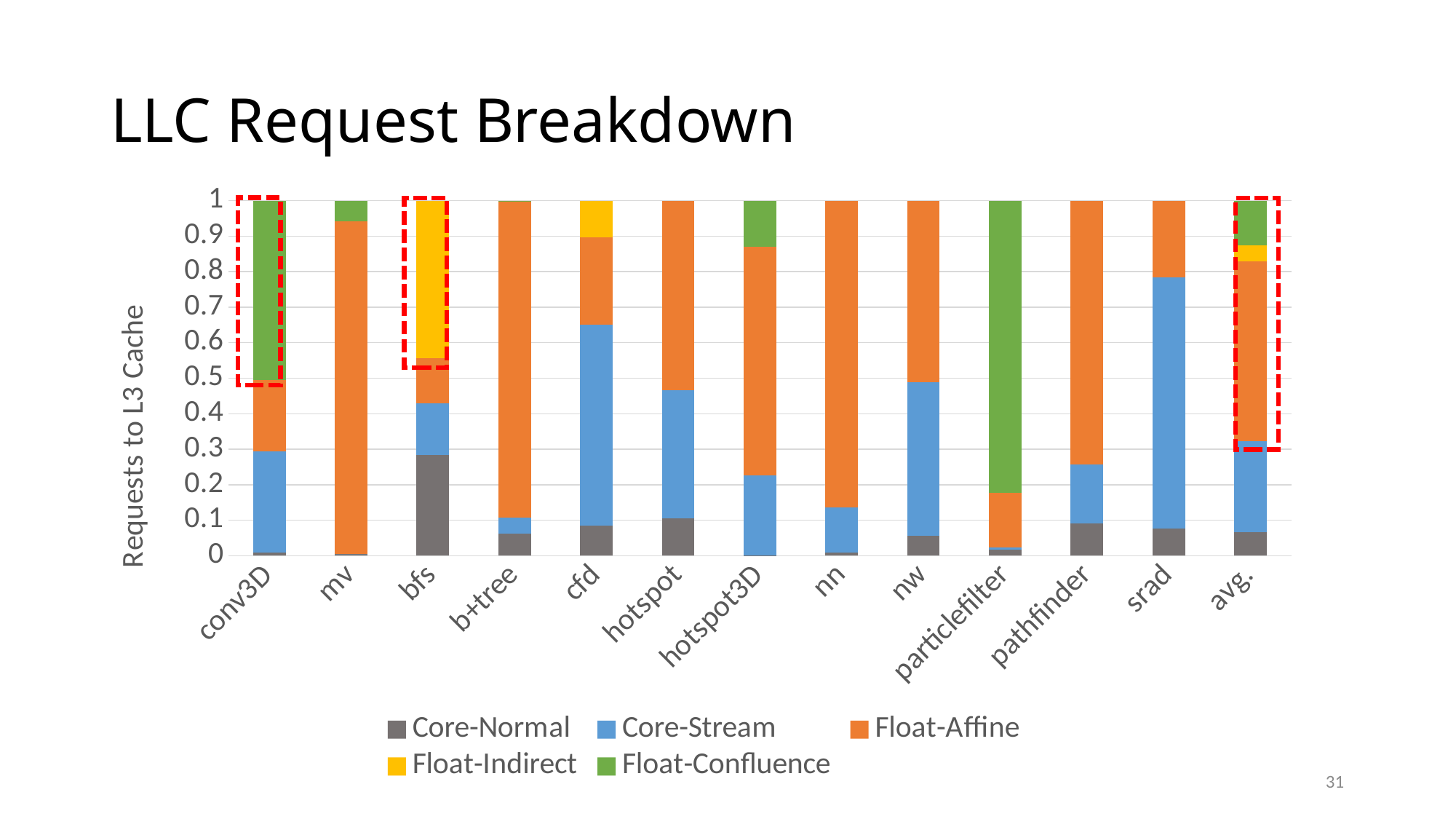
How many series does the legend list? 5 Is the Float-Indirect share for bfs greater or less than 0.3? greater Is the Float-Affine share for nn greater or less than 0.8? greater Which series is shown in green in the legend? Float-Confluence Which category has the largest Core-Stream share? srad Which category has the largest Core-Normal share? bfs Is the Core-Stream share for srad greater or less than 0.5? greater What is the label of the y axis? Requests to L3 Cache Which category has the largest Float-Confluence share? particlefilter Which has the larger Core-Stream share, cfd or hotspot? cfd What kind of chart is shown on the slide? Stacked bar chart How many benchmark categories are shown along the x axis? 13